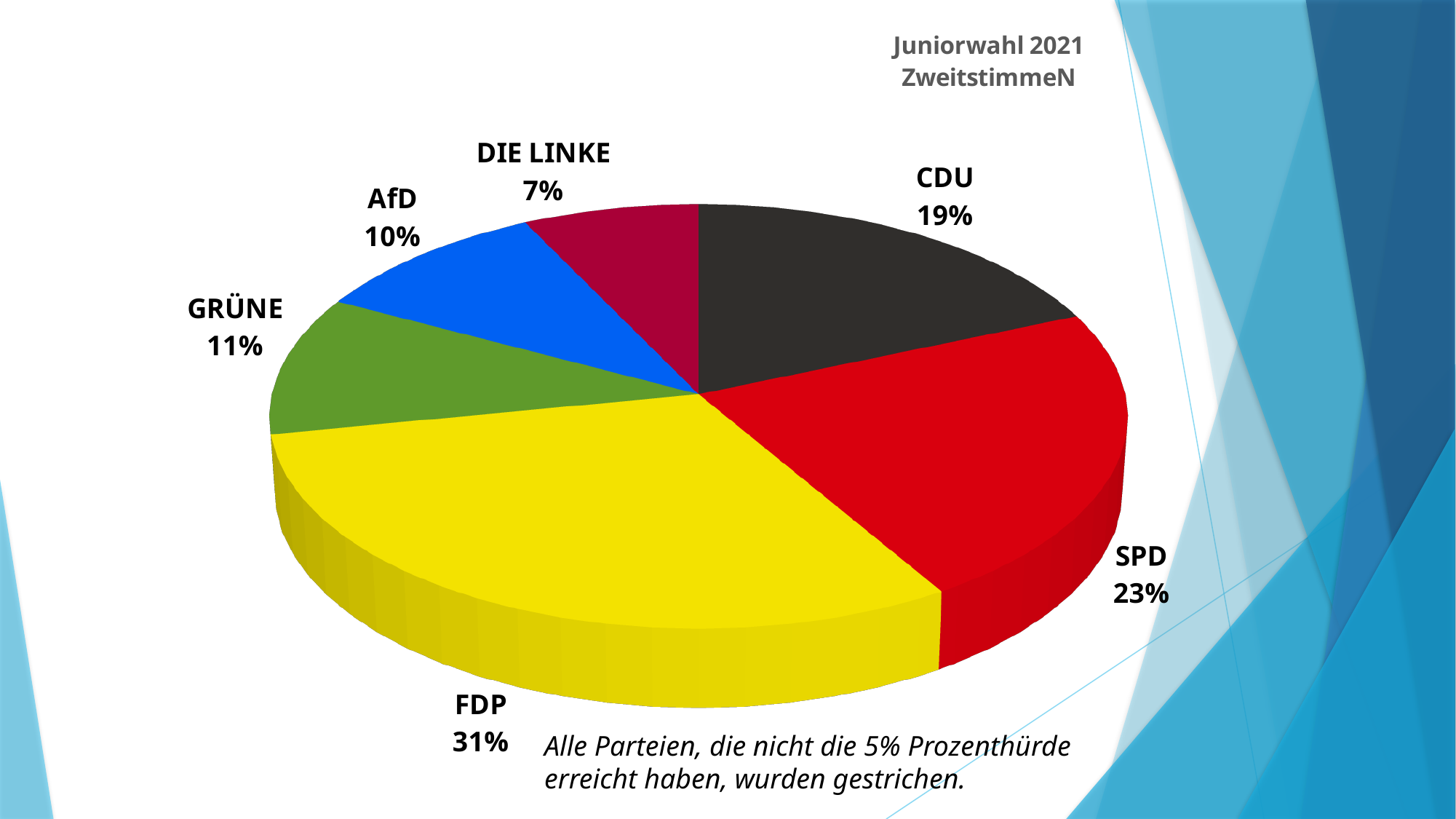
How many parties are shown in the pie chart? 6 Which has a larger share, CDU or SPD? SPD What kind of chart is shown on the slide? Pie chart What is the difference between the GRÜNE share and the AfD share? 1% Which party has the smallest slice of the pie? DIE LINKE What share of the pie does SPD have? 23% What share of the pie does CDU have? 19% Which party has the largest slice of the pie? FDP What share of the pie does FDP have? 31% What share of the pie does DIE LINKE have? 7% What is the difference between the FDP share and the SPD share? 8% What is the title of the chart? Juniorwahl 2021 ZweitstimmeN